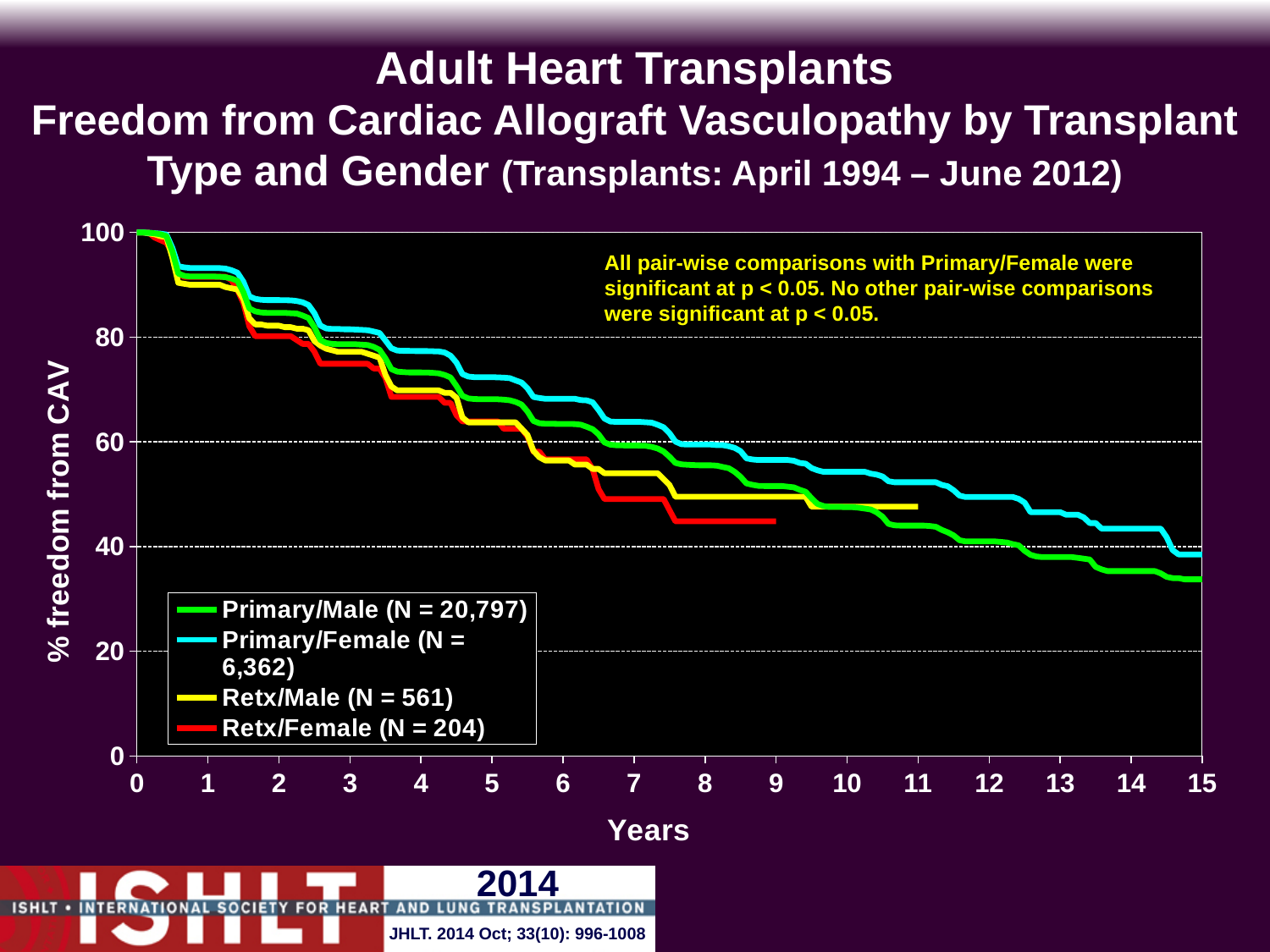
What colour is the Retx/Female line? red Is the value for Primary/Female at year 10 greater or less than 60? less Do the values for Primary/Male rise or fall as the years increase? fall Is the value for Retx/Female at year 9 greater or less than 60? less Is the value for Primary/Male at year 15 greater or less than 40? less What kind of chart is shown on the slide? line chart Which series has the highest % freedom from CAV at year 10? Primary/Female What is the N for the Primary/Male series shown in the legend? 20,797 How many series does the legend list? 4 At year 8, which is larger: the value for Primary/Female or the value for Retx/Female? Primary/Female